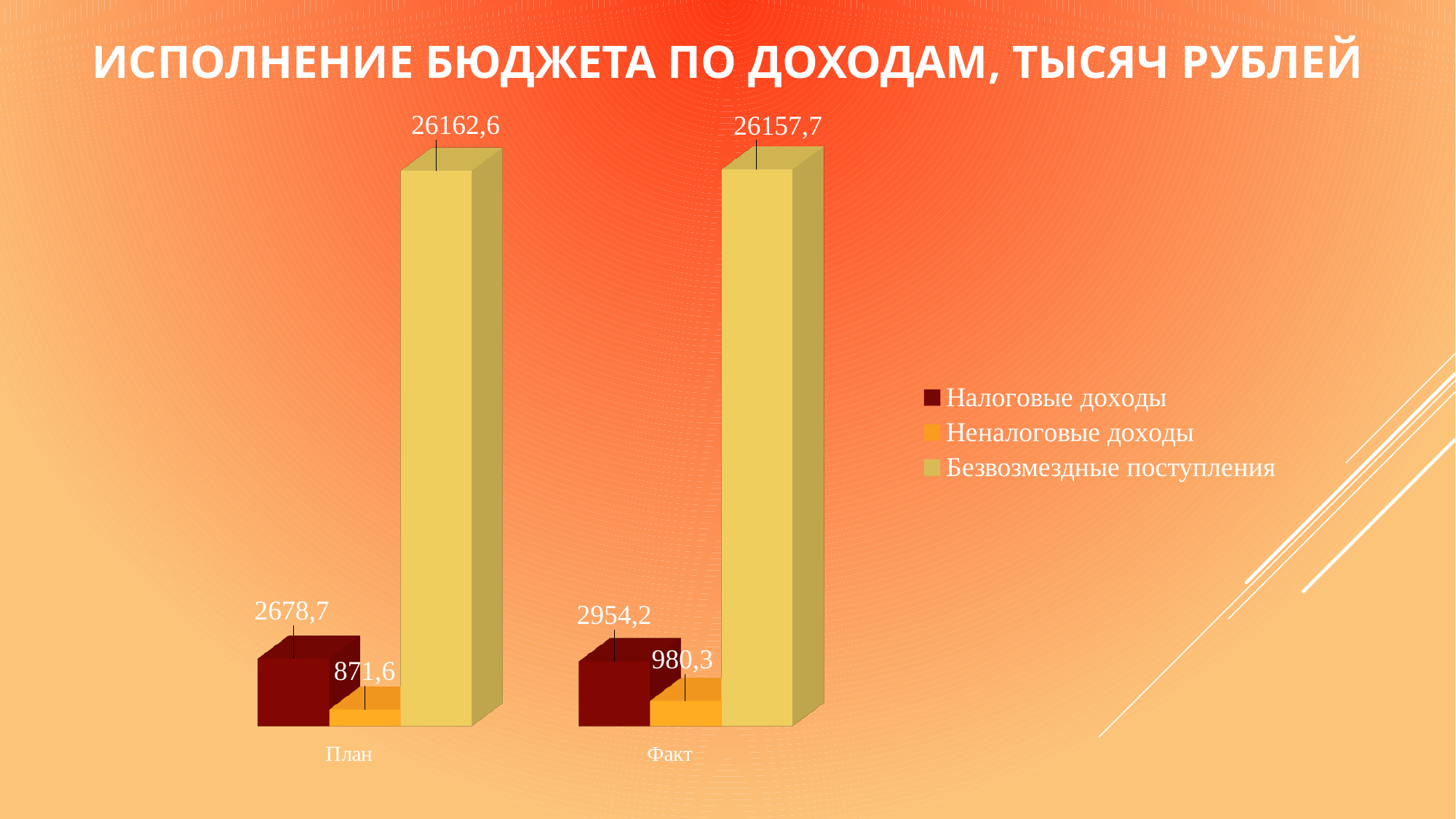
What is the value of Налоговые доходы for План? 2678,7 What is the difference between the Факт and План values for Налоговые доходы? 275,5 How many series does the legend list? 3 Which is larger: Налоговые доходы for План or Налоговые доходы for Факт? Факт What is the difference between the Факт and План values for Неналоговые доходы? 108,7 Which series has the highest value in the Факт category? Безвозмездные поступления What is the value of Неналоговые доходы for Факт? 980,3 What is the value of Безвозмездные поступления for План? 26162,6 Which series has the lowest value in the План category? Неналоговые доходы What kind of chart is shown on the slide? Bar chart What is the value of Безвозмездные поступления for Факт? 26157,7 How many categories are shown on the x axis? 2